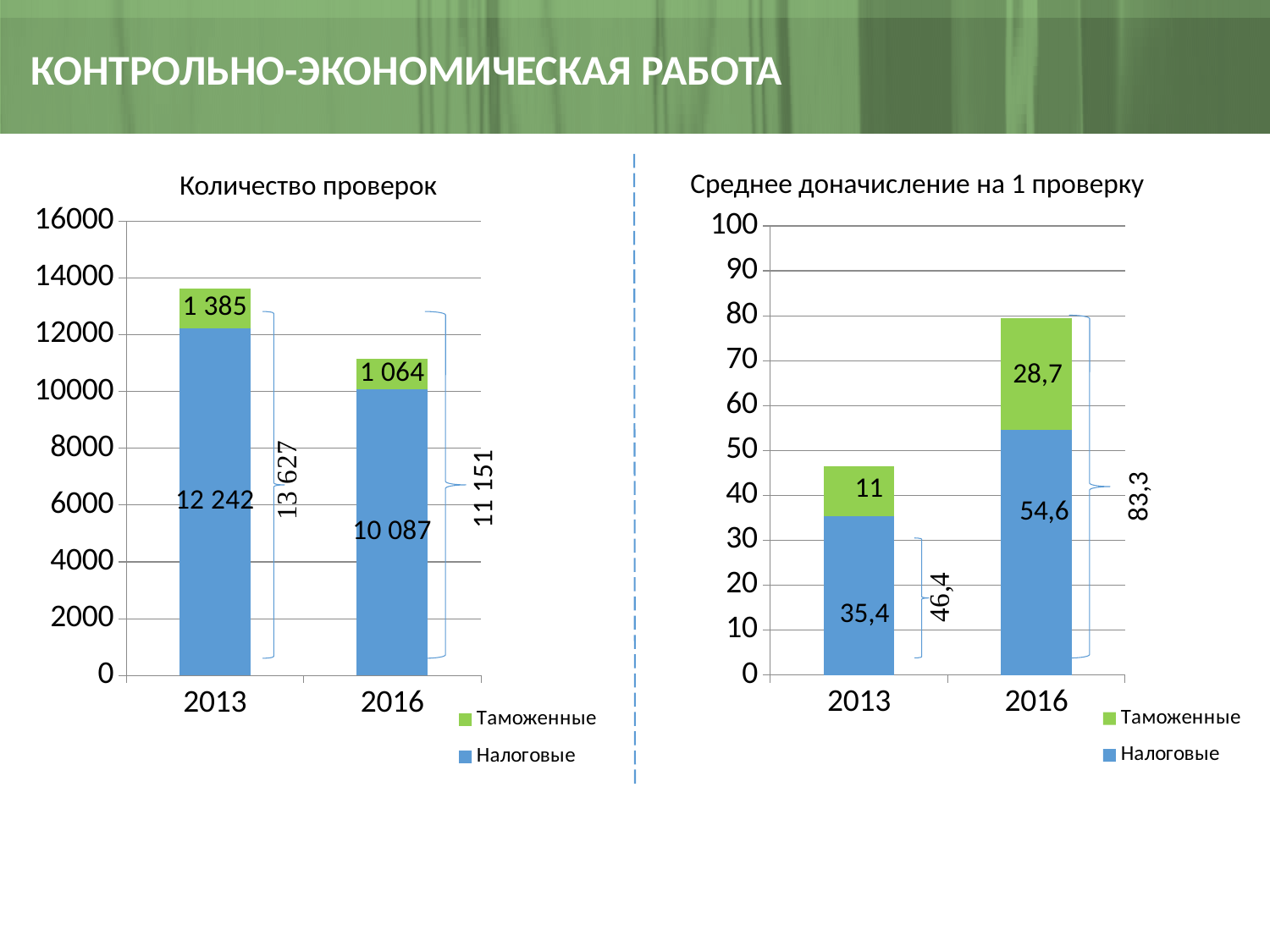
In the 'Среднее доначисление на 1 проверку' chart, which year has the higher Налоговые value, 2013 or 2016? 2016 How many series does the legend of the 'Количество проверок' chart list? 2 In the 'Количество проверок' chart, what is the difference between the Налоговые values for 2013 and 2016? 2 155 In the 'Количество проверок' chart, what is the value for Таможенные in 2016? 1 064 In the 'Среднее доначисление на 1 проверку' chart, what is the total of the stacked bar for 2016? 83,3 In the 'Среднее доначисление на 1 проверку' chart, what is the value for Налоговые in 2013? 35,4 In the 'Количество проверок' chart, do the totals rise or fall from 2013 to 2016? fall In the 'Количество проверок' chart, what is the total of the stacked bar for 2016? 11 151 In the 'Количество проверок' chart, what is the value for Налоговые in 2013? 12 242 In the 'Среднее доначисление на 1 проверку' chart, what is the value for Таможенные in 2016? 28,7 In the 'Среднее доначисление на 1 проверку' chart, is the total for 2013 greater or less than 50? less What kind of chart is the 'Среднее доначисление на 1 проверку' chart? stacked bar chart